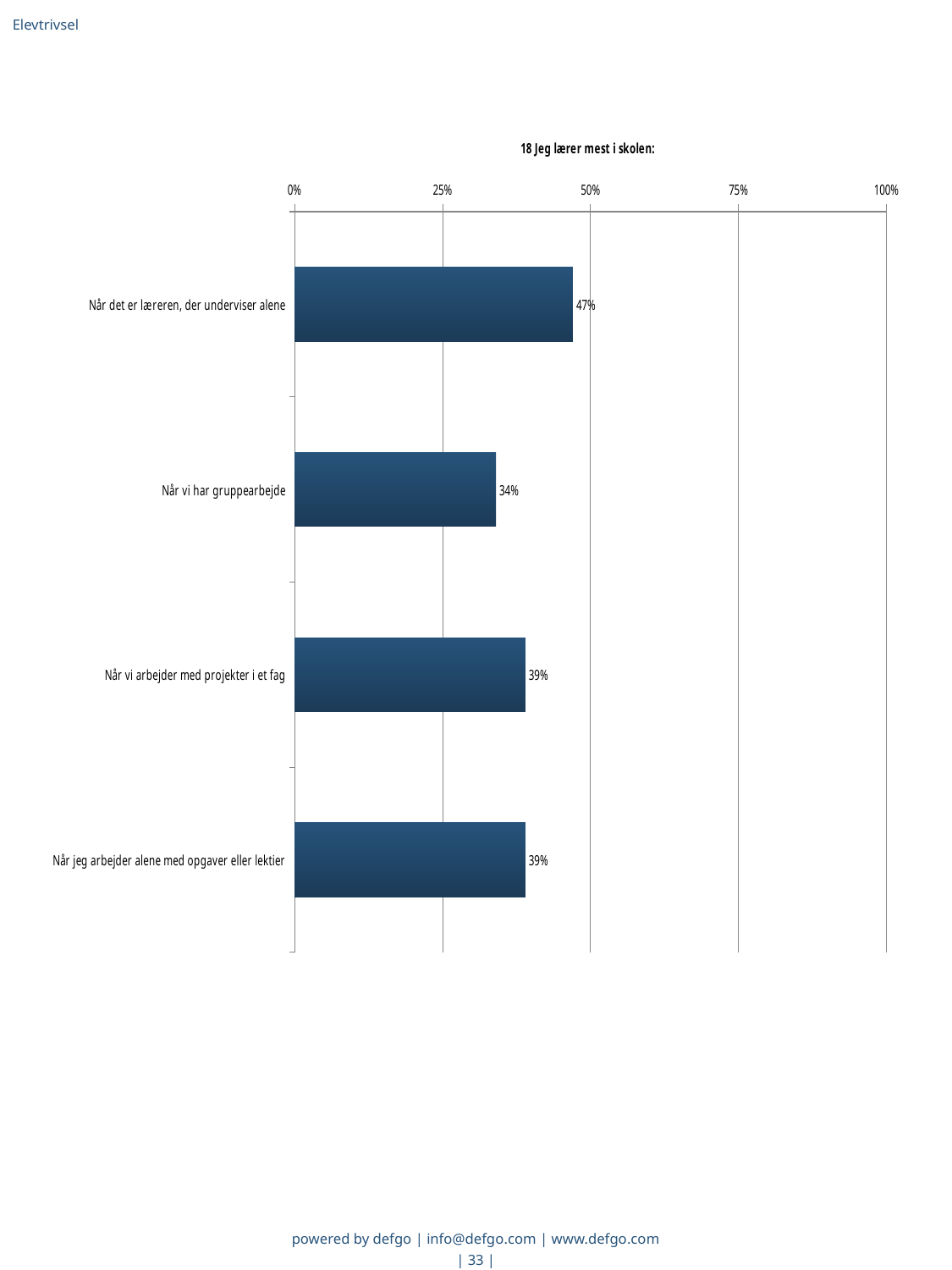
What is the value for 'Når vi arbejder med projekter i et fag'? 39% How many categories are shown in the chart? 4 What is the difference between the values for 'Når det er læreren, der underviser alene' and 'Når vi har gruppearbejde'? 13% Which is larger: the value for 'Når vi har gruppearbejde' or for 'Når vi arbejder med projekter i et fag'? Når vi arbejder med projekter i et fag What is the value for 'Når det er læreren, der underviser alene'? 47% Which category has the lowest value? Når vi har gruppearbejde What is the value for 'Når jeg arbejder alene med opgaver eller lektier'? 39% Is the value for 'Når det er læreren, der underviser alene' greater or less than 50%? less What kind of chart is shown on the slide? bar chart What is the value for 'Når vi har gruppearbejde'? 34% What is the title of the chart? 18 Jeg lærer mest i skolen: Which category has the highest value? Når det er læreren, der underviser alene